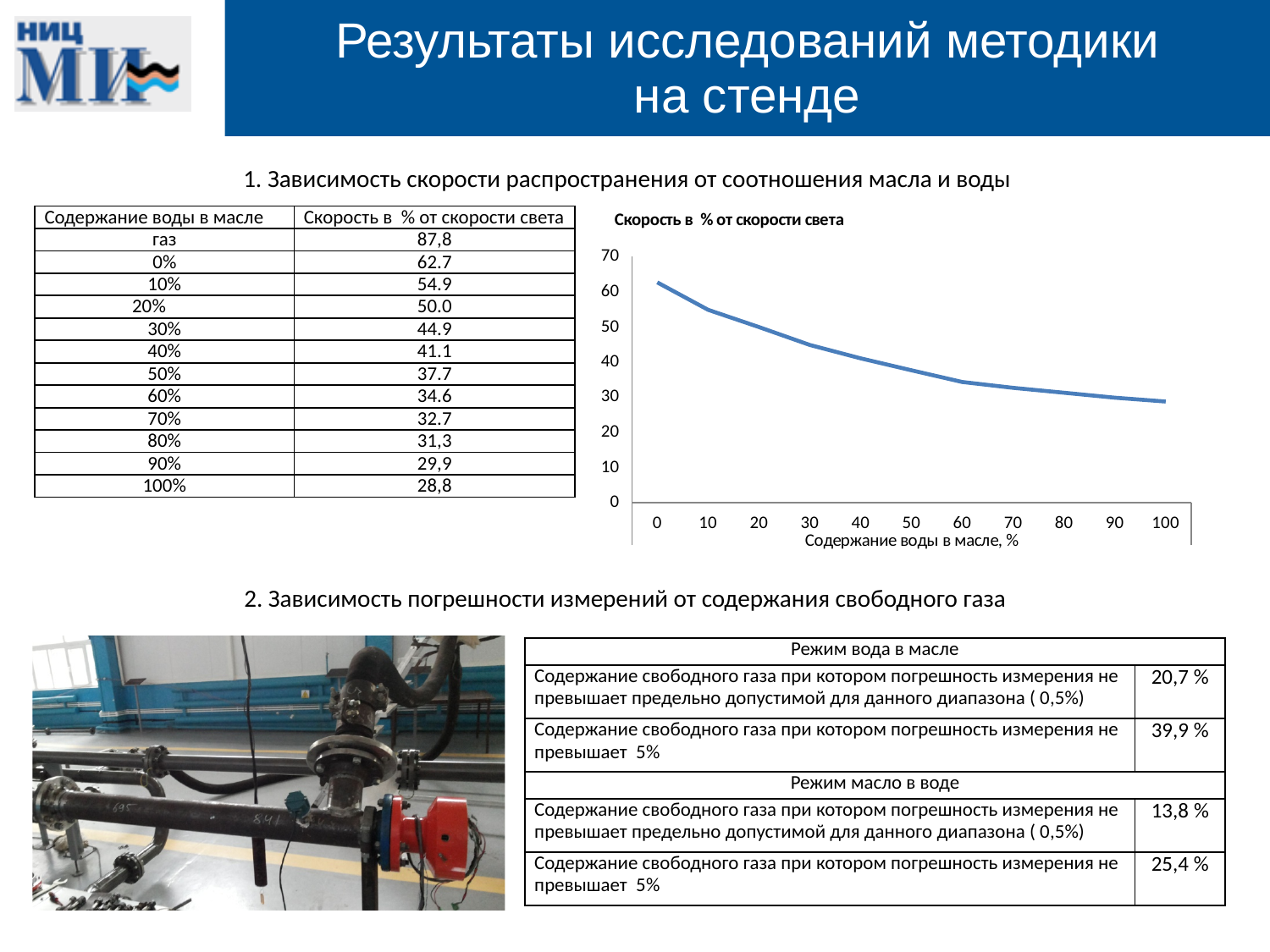
What is the label of the x axis of the chart? Содержание воды в масле, % At which water content value on the x axis is the plotted speed lowest? 100 What kind of chart is shown on the slide? line chart How many data points are plotted on the line chart (one per x-axis tick from 0 to 100)? 11 What is the title of the chart? Скорость в % от скорости света Is the plotted value at water content 0 greater or less than 60? greater Is the plotted value at water content 30 greater or less than 40? greater Is the plotted value at water content 100 greater or less than 30? less Do the values on the chart rise or fall as the water content in oil increases along the x axis? fall At which water content value on the x axis is the plotted speed highest? 0 Which is larger on the chart: the value at water content 10 or the value at water content 70? the value at 10